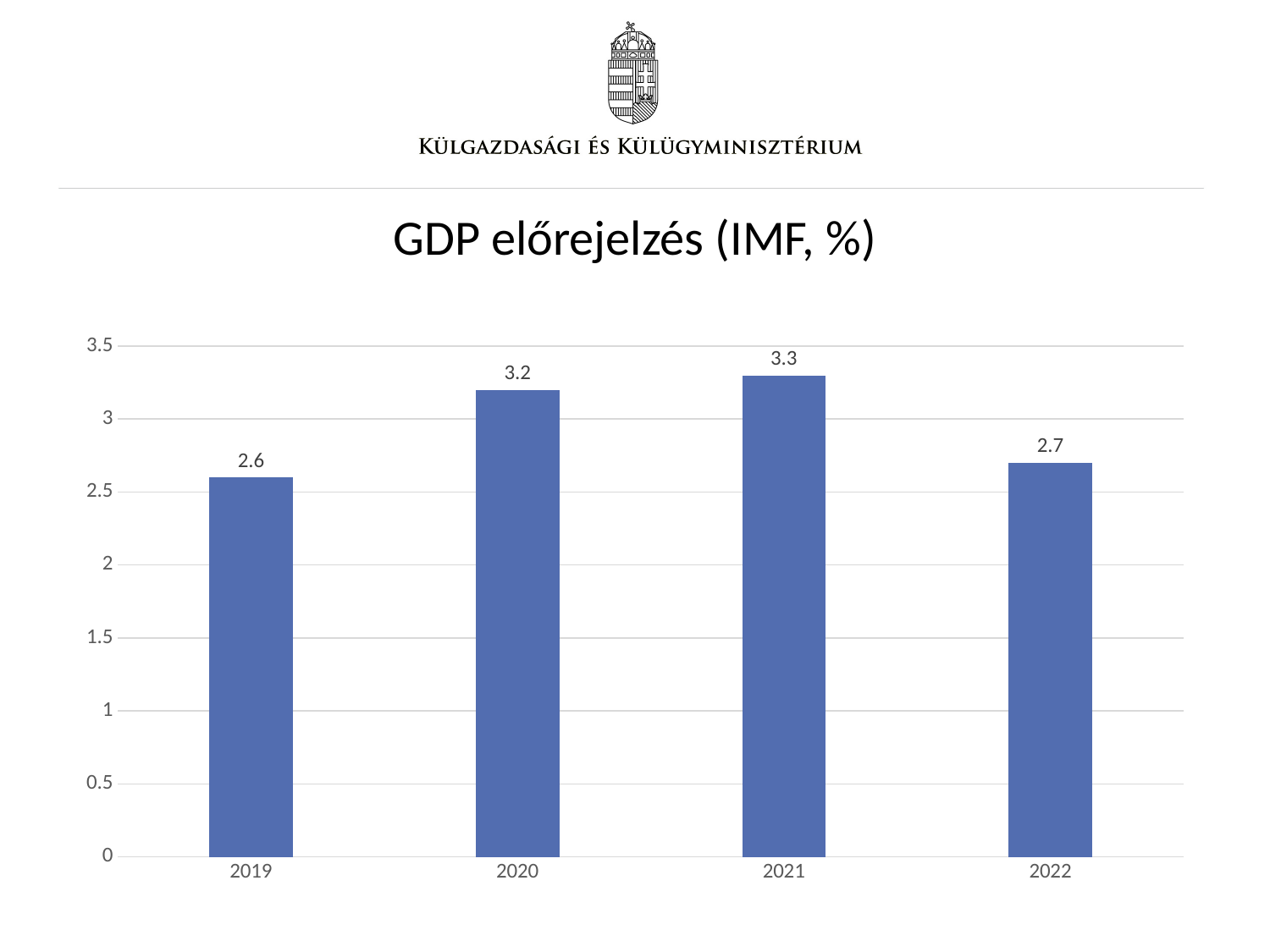
What is the difference between the GDP forecast for 2020 and 2022? 0.5 What kind of chart is shown on the slide? Bar chart Which year has the highest GDP forecast? 2021 Which year has a larger GDP forecast, 2020 or 2022? 2020 How many years are shown on the chart? 4 Which year has the lowest GDP forecast? 2019 Is the GDP forecast for 2020 greater or less than 3? greater What is the difference between the GDP forecast for 2021 and 2019? 0.7 What is the GDP forecast value for 2022? 2.7 What is the GDP forecast value for 2019? 2.6 What is the GDP forecast value for 2021? 3.3 What is the title of the chart? GDP előrejelzés (IMF, %)